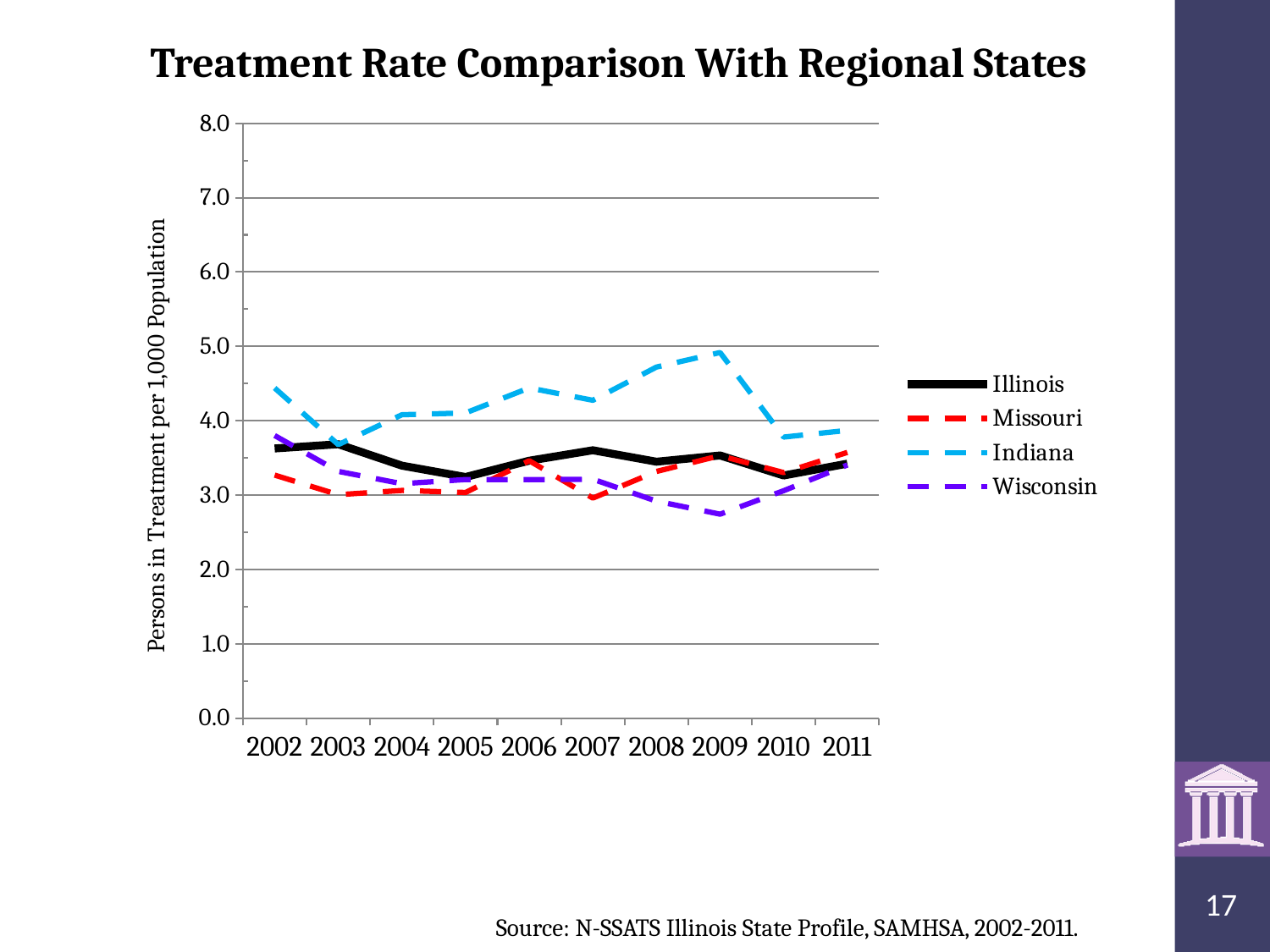
What kind of chart is shown on the slide? line chart Does the value for Indiana rise or fall from 2009 to 2010? fall What is the label on the y axis? Persons in Treatment per 1,000 Population In 2008, which is larger: the value for Indiana or the value for Illinois? Indiana Which state has the lowest treatment rate in 2009? Wisconsin Which state has the highest treatment rate in 2009? Indiana Is the value for Wisconsin in 2009 greater or less than 3.0? less Is the value for Indiana in 2002 greater or less than 4.0? greater How many series does the legend list? 4 How many years are shown along the x axis? 10 Is the value for Indiana in 2009 greater or less than 4.0? greater Which state has the highest treatment rate in 2002? Indiana